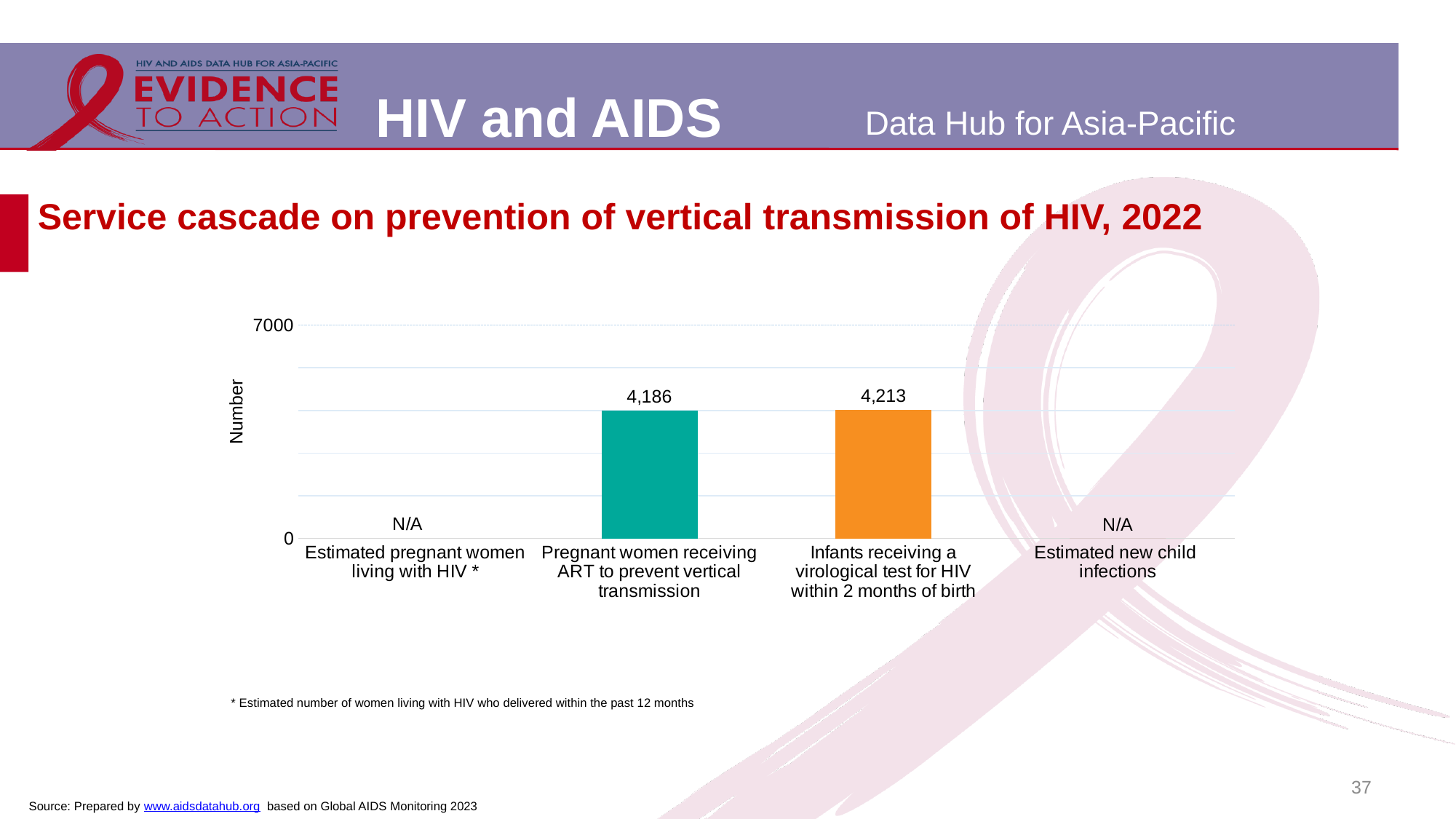
What is the value for Infants receiving a virological test for HIV within 2 months of birth? 4,213 How many categories on the chart are marked N/A? 2 What is shown for Estimated pregnant women living with HIV? N/A What is shown for Estimated new child infections? N/A What is the label of the vertical axis of the chart? Number What kind of chart is shown on the slide? bar chart What is the value for Pregnant women receiving ART to prevent vertical transmission? 4,186 Which is larger: the value for Pregnant women receiving ART to prevent vertical transmission or the value for Infants receiving a virological test for HIV within 2 months of birth? Infants receiving a virological test for HIV within 2 months of birth What is the title of the chart on the slide? Service cascade on prevention of vertical transmission of HIV, 2022 What is the difference between the value for Infants receiving a virological test for HIV within 2 months of birth and the value for Pregnant women receiving ART to prevent vertical transmission? 27 Is the value for Pregnant women receiving ART to prevent vertical transmission greater or less than 7000? less How many categories are shown on the x axis of the chart? 4